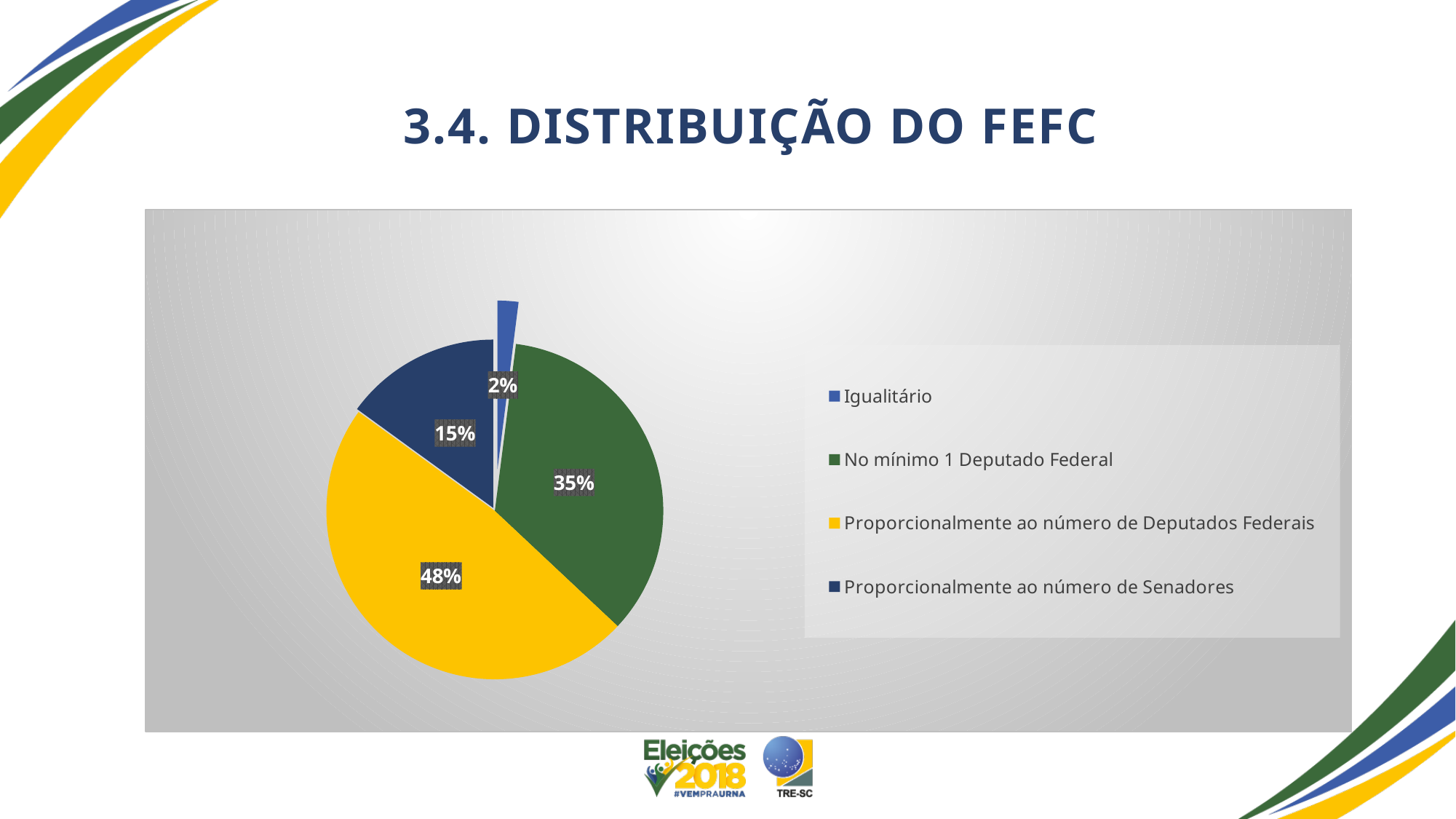
What share of the pie does "Igualitário" represent? 2% Which category has the smallest slice of the pie? Igualitário What share of the pie does "Proporcionalmente ao número de Deputados Federais" represent? 48% Which category has the largest slice of the pie? Proporcionalmente ao número de Deputados Federais What is the title of the slide containing the chart? 3.4. DISTRIBUIÇÃO DO FEFC What share of the pie does "No mínimo 1 Deputado Federal" represent? 35% How many slices does the pie chart have? 4 What is the difference between the shares of "Proporcionalmente ao número de Deputados Federais" and "No mínimo 1 Deputado Federal"? 13% What colour is the slice for "Proporcionalmente ao número de Deputados Federais"? yellow What kind of chart is shown on the slide? pie chart Which is larger: the share for "Proporcionalmente ao número de Senadores" or the share for "No mínimo 1 Deputado Federal"? No mínimo 1 Deputado Federal